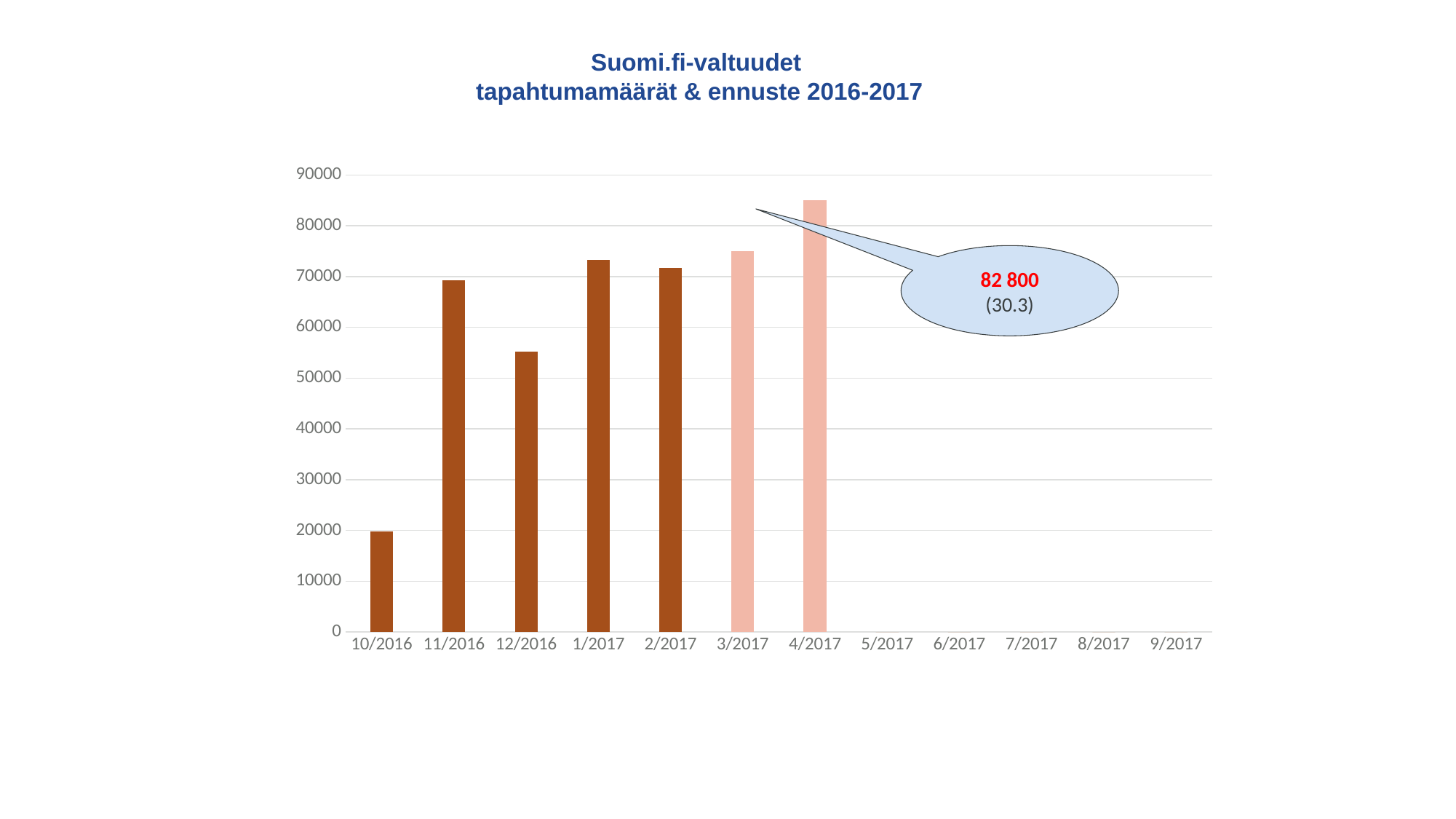
What kind of chart is shown on the slide? bar chart Which is larger, the value for 11/2016 or 12/2016? 11/2016 Which month has the lowest bar? 10/2016 Is the value for 12/2016 greater or less than 50000? greater Is the value for 1/2017 greater or less than 70000? greater Is the value for 10/2016 greater or less than 30000? less What is the title of the chart? Suomi.fi-valtuudet tapahtumamäärät & ennuste 2016-2017 How many month categories are shown on the x axis? 12 Which month has the highest bar? 4/2017 What number is written in red in the callout bubble? 82 800 How many months have a bar plotted? 7